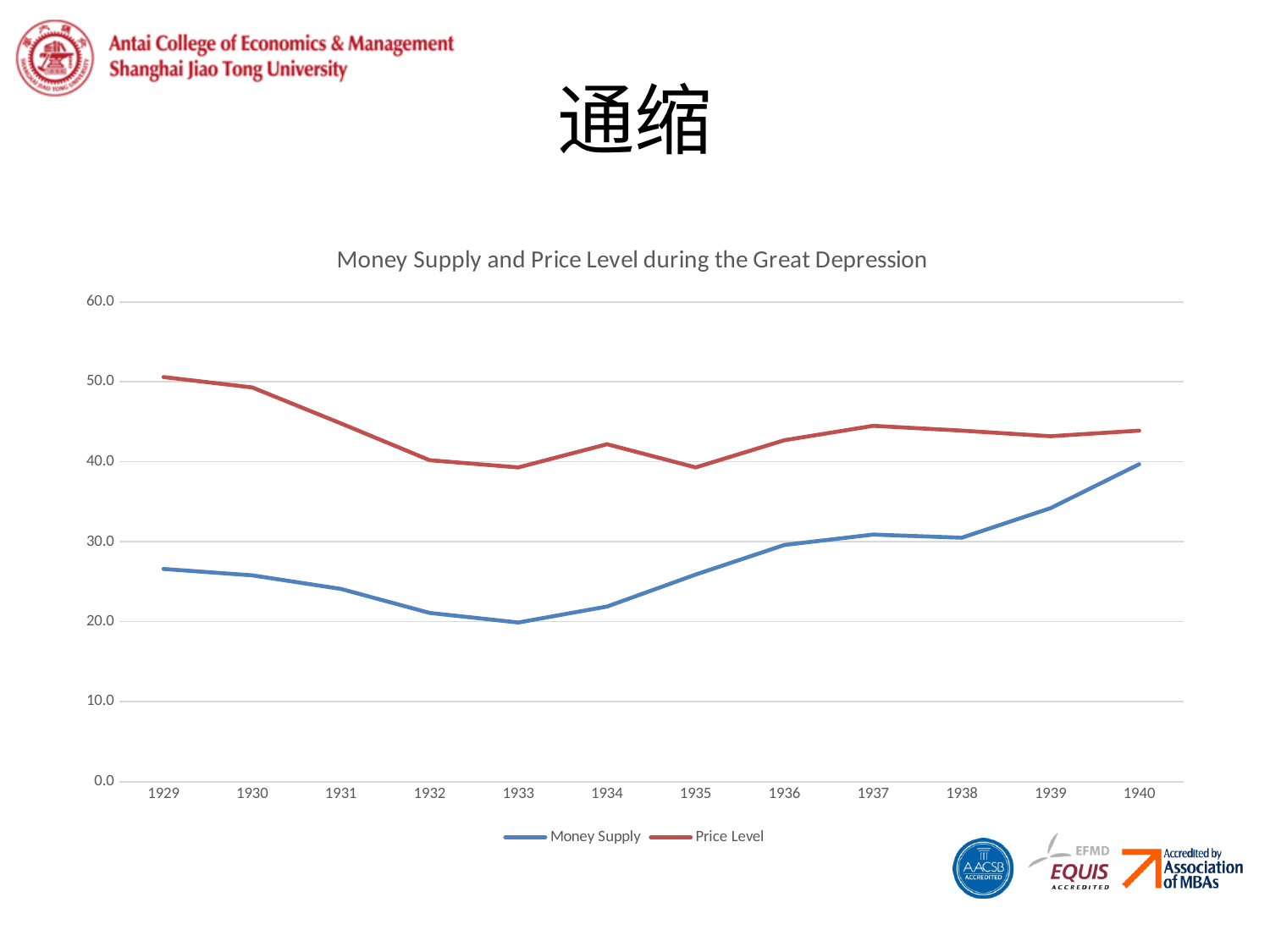
How many series does the legend list? 2 Is the value for Price Level in 1937 greater or less than 40? greater Which series is drawn in red? Price Level What is the title of the chart? Money Supply and Price Level during the Great Depression What kind of chart is shown on the slide? line chart In which year is the Money Supply line at its highest? 1940 Does the Money Supply line rise or fall from 1933 to 1940? rise Which is larger in 1933, Money Supply or Price Level? Price Level In which year is the Price Level line at its highest? 1929 Is the value for Money Supply in 1929 greater or less than 20? greater In which year is the Money Supply line at its lowest? 1933 How many years are plotted along the x axis? 12